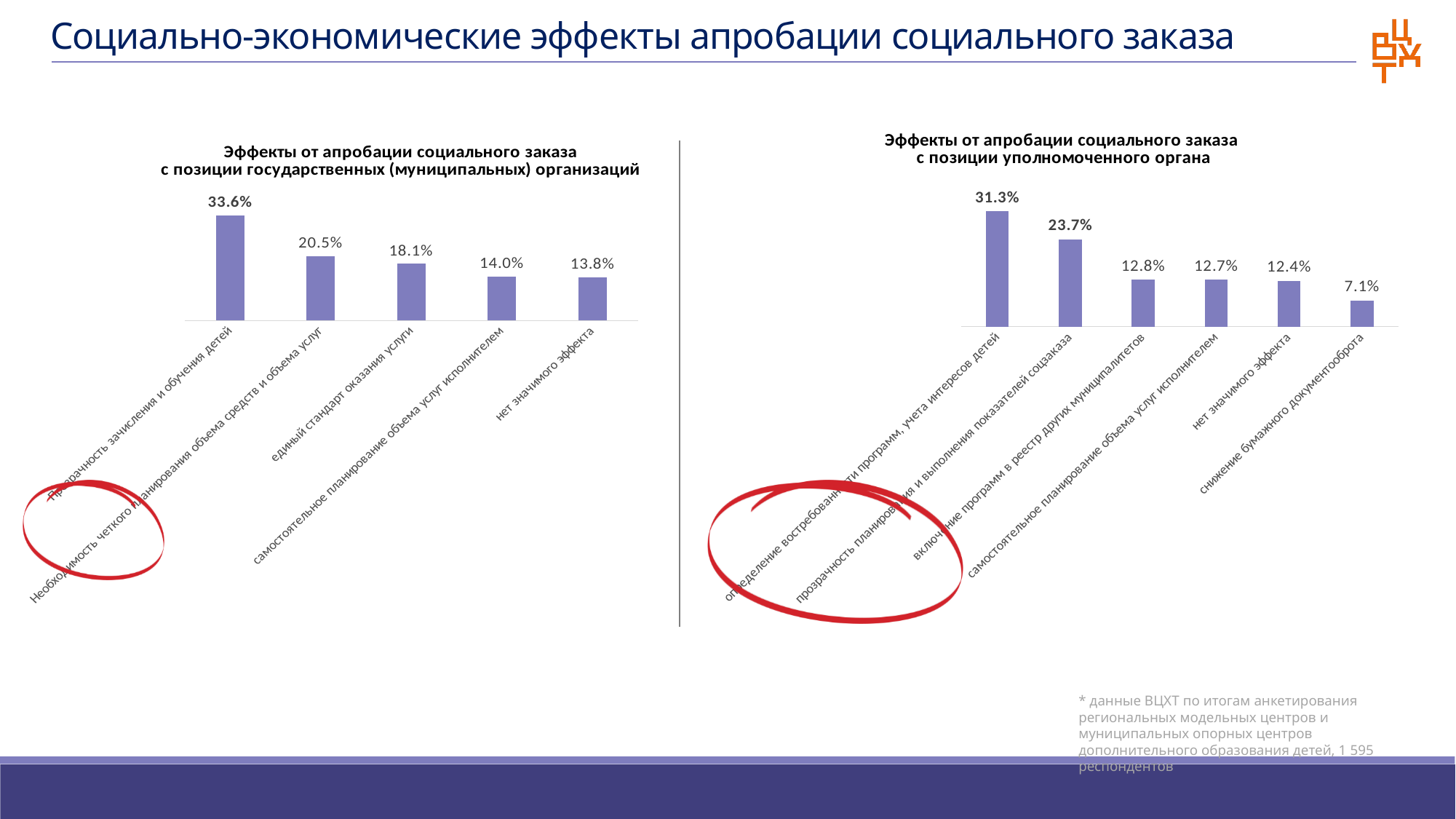
How many categories are shown in the right chart (с позиции уполномоченного органа)? 6 Which is larger: the value for "нет значимого эффекта" in the left chart or the value for "нет значимого эффекта" in the right chart? the left chart (13.8%) In the left chart (с позиции государственных (муниципальных) организаций), what is the value for "единый стандарт оказания услуги"? 18.1% In the right chart (с позиции уполномоченного органа), what is the value for "снижение бумажного документооборота"? 7.1% In the left chart (с позиции государственных (муниципальных) организаций), which category has the highest value? Прозрачность зачисления и обучения детей In the left chart (с позиции государственных (муниципальных) организаций), what is the value for "нет значимого эффекта"? 13.8% What type of chart is the right chart (с позиции уполномоченного органа)? bar chart In the right chart (с позиции уполномоченного органа), what is the difference between the values for "определение востребованности программ, учета интересов детей" and "прозрачность планирования и выполнения показателей соцзаказа"? 7.6% In the right chart (с позиции уполномоченного органа), which category has the lowest value? снижение бумажного документооборота How many categories are shown in the left chart (с позиции государственных (муниципальных) организаций)? 5 In the left chart (с позиции государственных (муниципальных) организаций), what is the difference between the highest value and the value for "Необходимость четкого планирования объема средств и объема услуг"? 13.1% In the right chart (с позиции уполномоченного органа), what is the value for "прозрачность планирования и выполнения показателей соцзаказа"? 23.7%